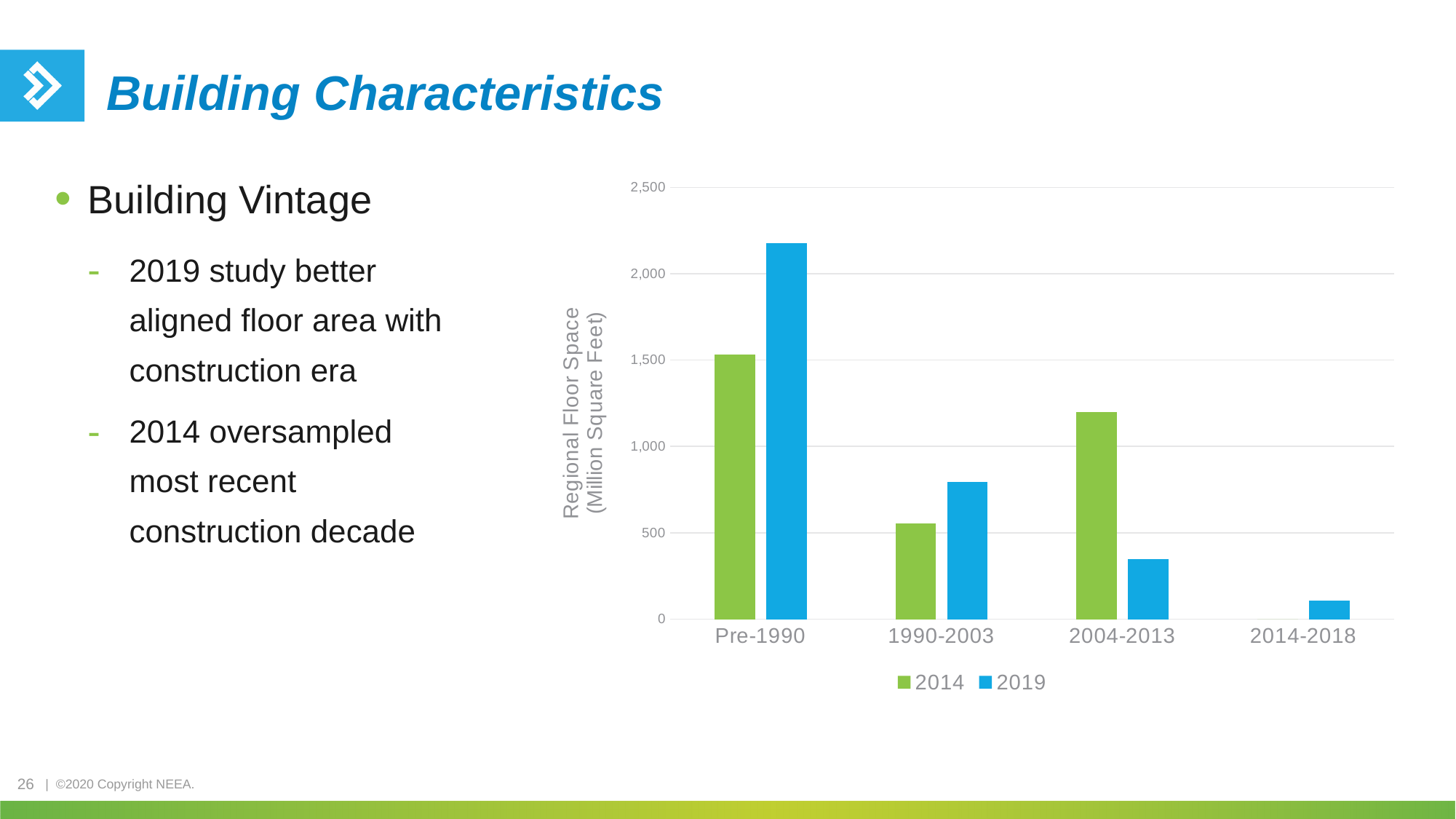
Which construction era has the highest 2019 value? Pre-1990 Do the 2019 values rise or fall moving from Pre-1990 to 2014-2018 along the x axis? fall For the Pre-1990 era, which series is larger, 2014 or 2019? 2019 Which construction era has the highest 2014 value? Pre-1990 Is the 2014 value for 1990-2003 greater or less than 1,000? less How many series does the legend list? 2 What kind of chart is shown on the slide? bar chart What is the label on the vertical axis of the chart? Regional Floor Space (Million Square Feet) How many construction-era categories are shown on the x axis? 4 Is the 2019 value for Pre-1990 greater or less than 2,000? greater Which construction era has the lowest 2019 value? 2014-2018 For the 2004-2013 era, which series is larger, 2014 or 2019? 2014